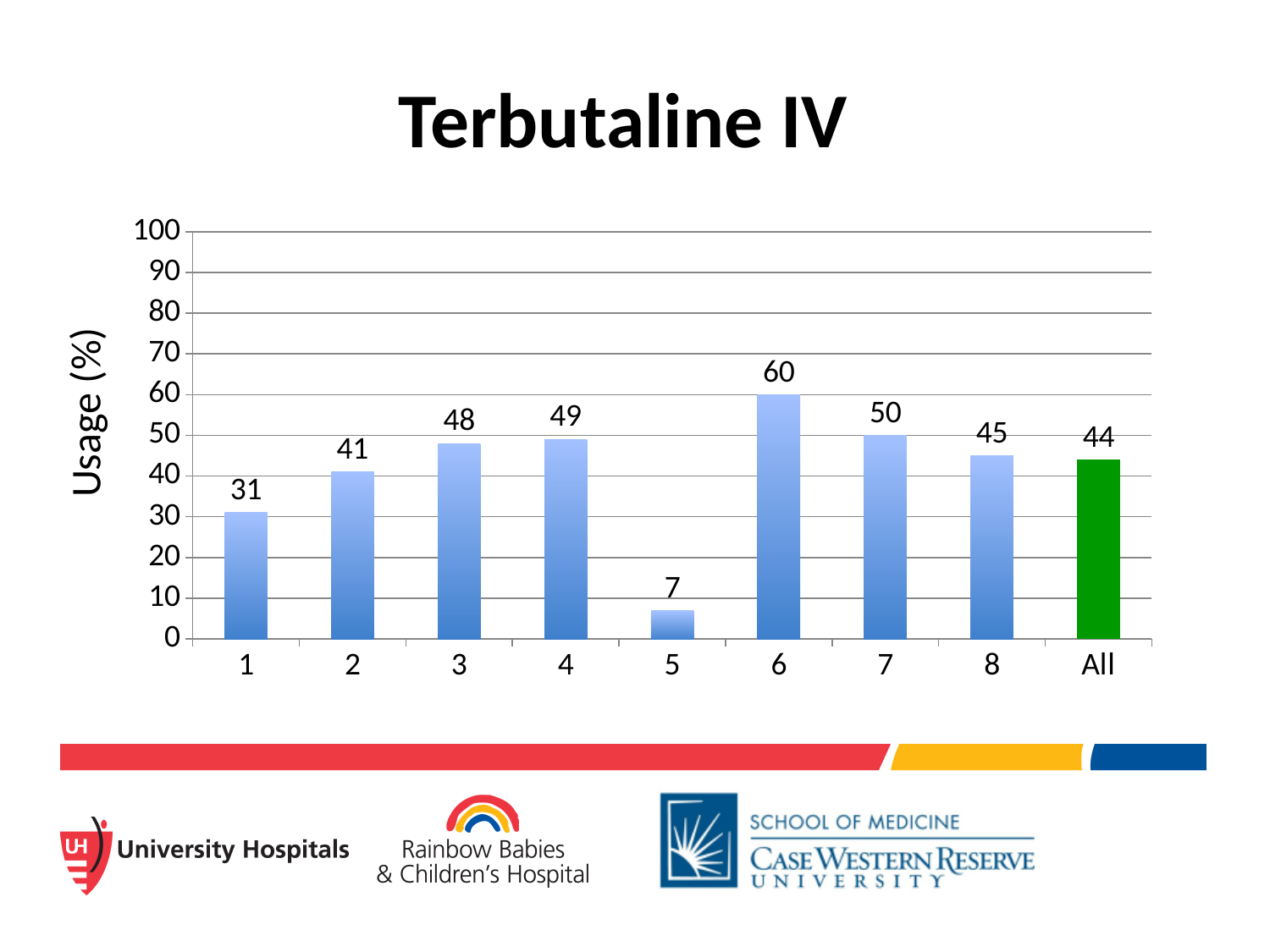
How many categories are shown on the x axis? 9 What kind of chart is shown on the slide? bar chart Which has higher usage, category 2 or category 7? 7 What is the label of the y axis? Usage (%) What is the difference in usage between category 6 and category 5? 53 Which category has the highest usage? 6 What is the usage (%) for category 6? 60 What is the usage (%) for the 'All' category? 44 What is the usage (%) for category 1? 31 Which category has the lowest usage? 5 What is the title of the chart? Terbutaline IV Is the value for category 8 greater or less than 40? greater